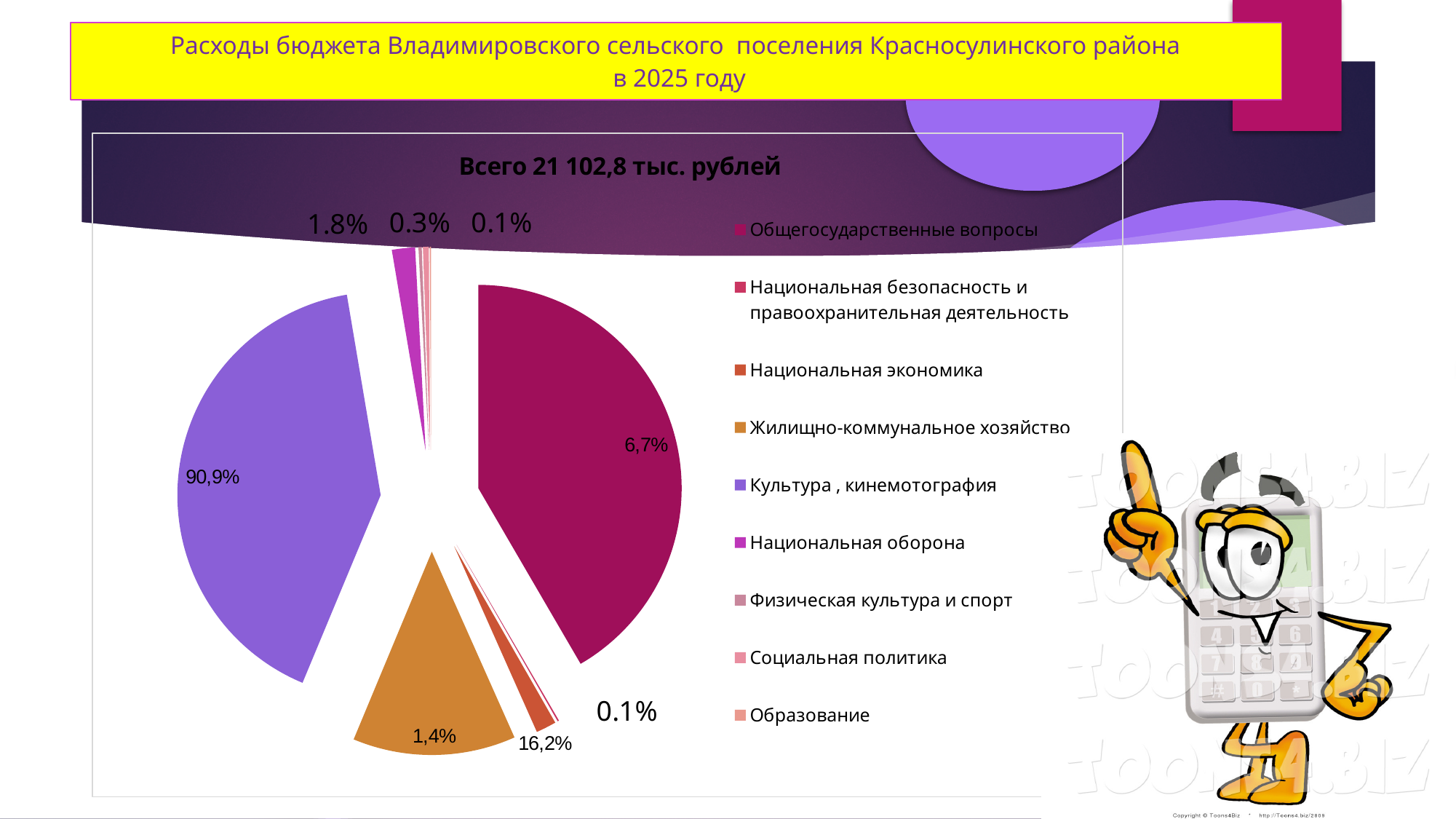
What colour is used for Культура , кинемотография in the legend? purple What kind of chart is shown on the slide? pie chart Which slice is larger: the purple one (Культура , кинемотография) or the orange one (Жилищно-коммунальное хозяйство)? Культура , кинемотография What percentage label is printed on the purple slice (Культура , кинемотография)? 90,9% How many categories does the legend of the pie chart list? 9 What total amount is stated in the chart title above the pie? Всего 21 102,8 тыс. рублей What percentage label is printed on the large magenta slice (Общегосударственные вопросы)? 6,7% Which year does the slide title say the budget expenditures refer to? 2025 What percentage label is printed on the orange slice (Жилищно-коммунальное хозяйство)? 1,4% Which slice is larger: Общегосударственные вопросы or Жилищно-коммунальное хозяйство? Общегосударственные вопросы